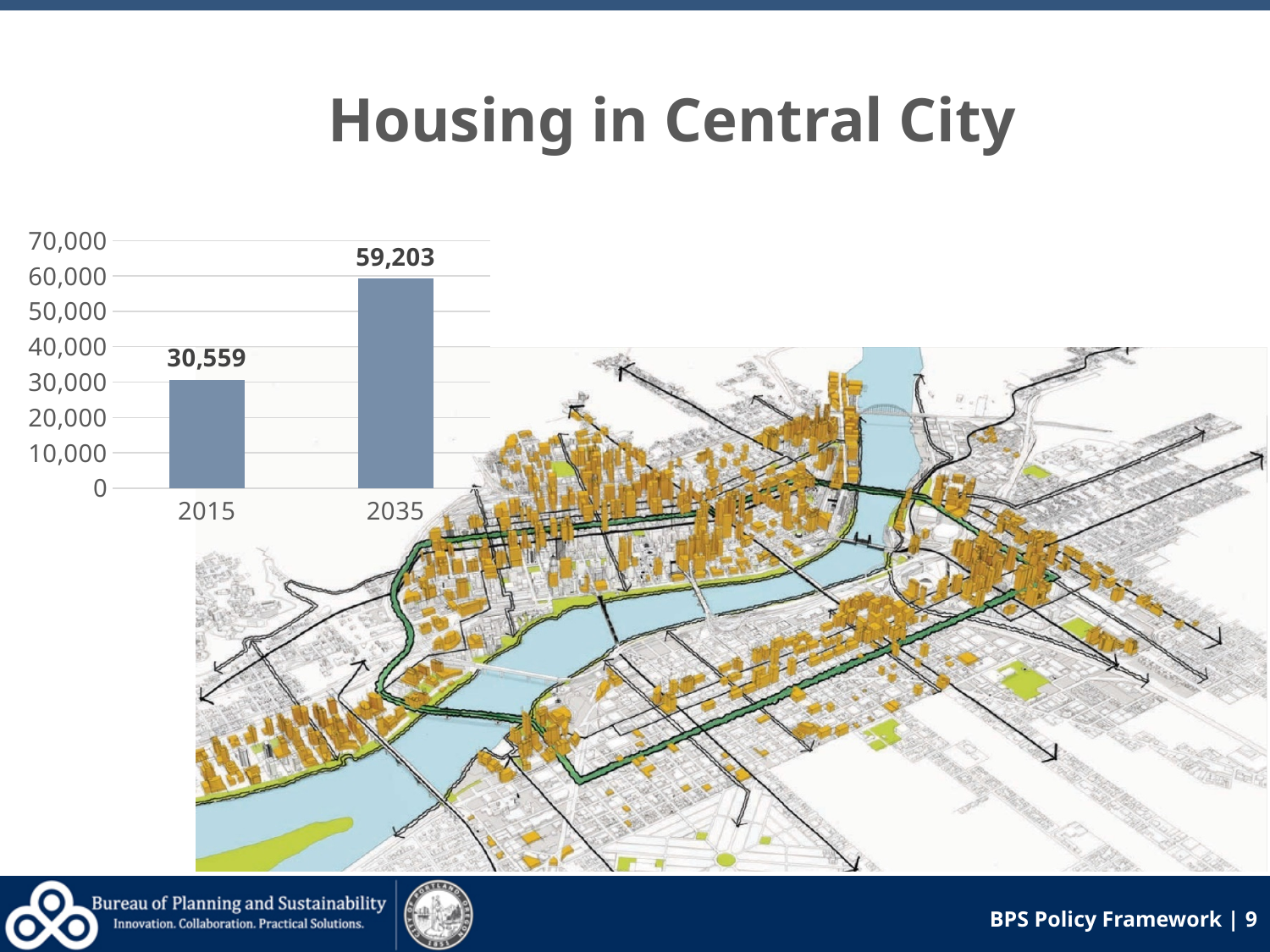
What is the title of the slide containing the chart? Housing in Central City Which year has the lower value? 2015 How many categories are shown on the x axis? 2 What is the difference between the 2035 and 2015 values? 28,644 What kind of chart is shown on the slide? bar chart Do the values rise or fall from 2015 to 2035? rise What is the value for 2015? 30,559 What is the value for 2035? 59,203 Is the value for 2015 greater or less than 40,000? less Is the value for 2035 greater or less than 50,000? greater Which year has the higher value? 2035 What is the highest value shown on the y axis? 70,000